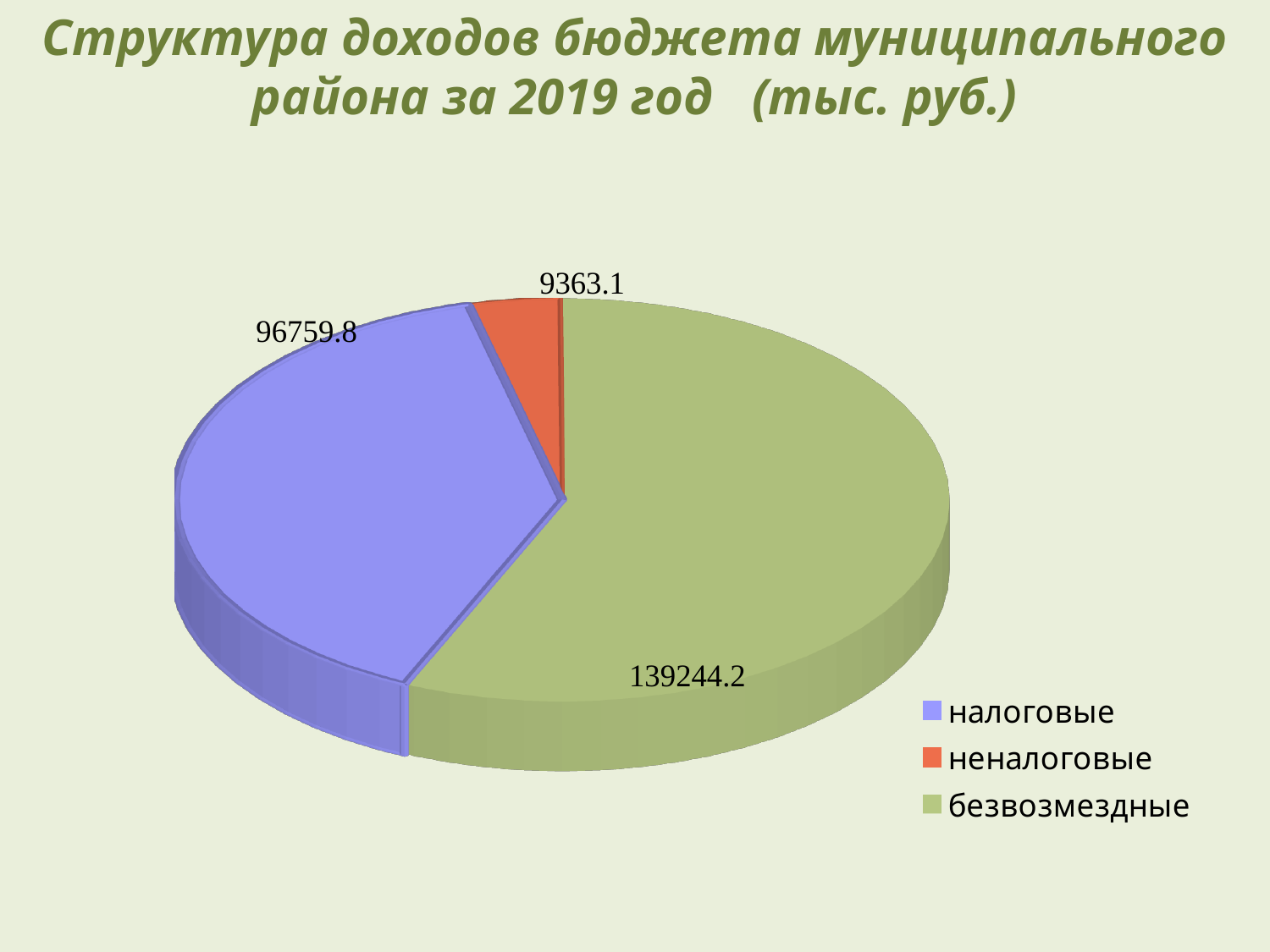
What colour is the slice for неналоговые? Red What is the total of all three slices? 245367.1 What is the value for безвозмездные? 139244.2 Which category has the largest value? безвозмездные How many slices does the pie chart have? 3 What is the difference between the values for налоговые and неналоговые? 87396.7 What is the value for неналоговые? 9363.1 What is the difference between the values for безвозмездные and налоговые? 42484.4 Which category has the smallest value? неналоговые Which is larger, налоговые or неналоговые? налоговые What type of chart is shown on the slide? Pie chart What is the value for налоговые? 96759.8